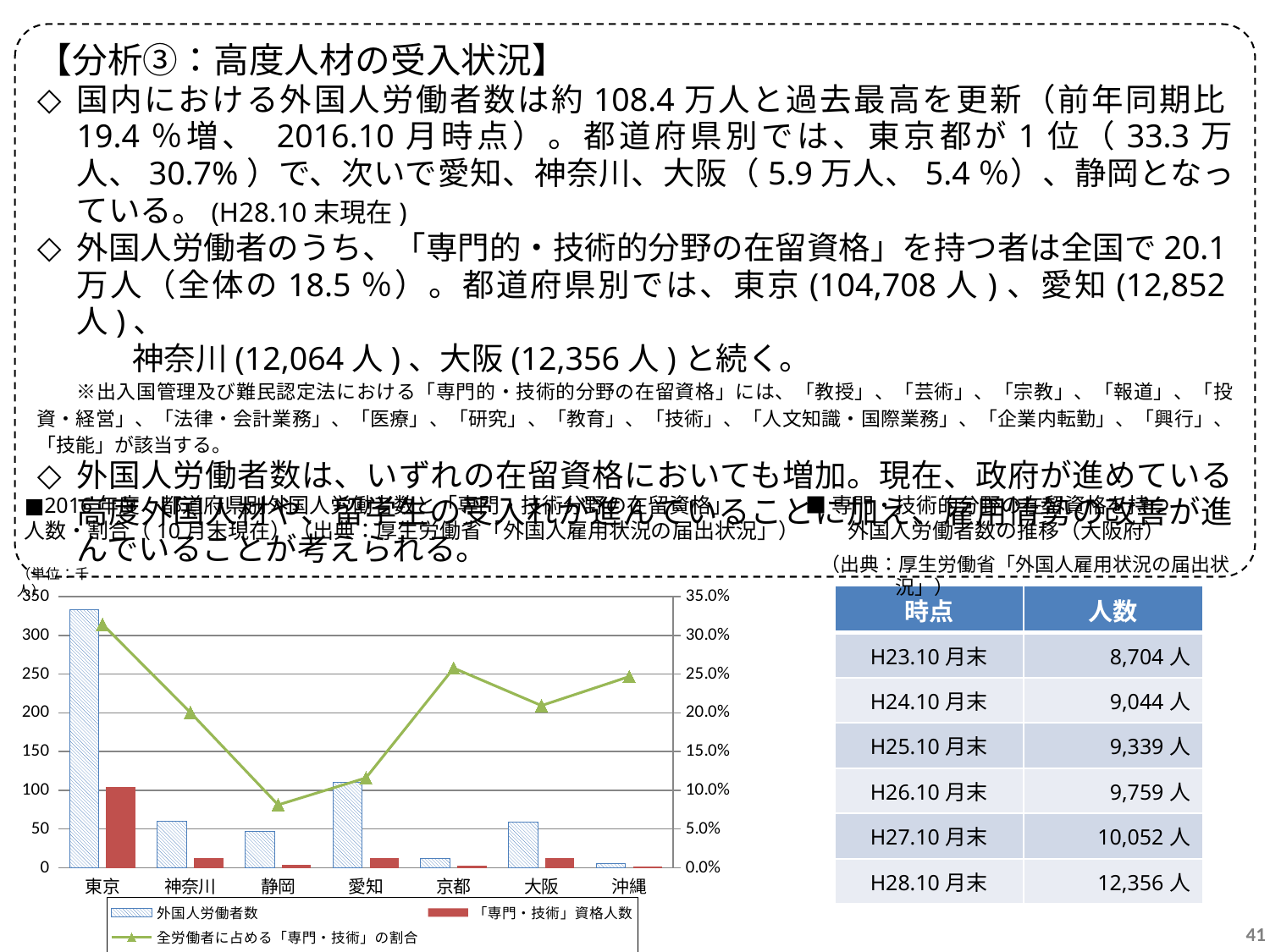
Which has the larger 外国人労働者数 bar, 神奈川 or 静岡? 神奈川 Is the 全労働者に占める「専門・技術」の割合 value for 静岡 greater or less than 10.0%? less Is the 外国人労働者数 value for 京都 greater or less than 50? less Which legend entry is drawn as a line with triangle markers? 全労働者に占める「専門・技術」の割合 Which prefecture has the highest value on the 全労働者に占める「専門・技術」の割合 line? 東京 Which prefecture has the highest 外国人労働者数 bar? 東京 Is the 外国人労働者数 value for 東京 greater or less than 300? greater How many series does the chart's legend list? 3 What kind of chart is shown at the bottom left of the slide? A bar chart combined with a line How many prefectures are shown on the x axis of the chart? 7 Which prefecture has the lowest value on the 全労働者に占める「専門・技術」の割合 line? 静岡